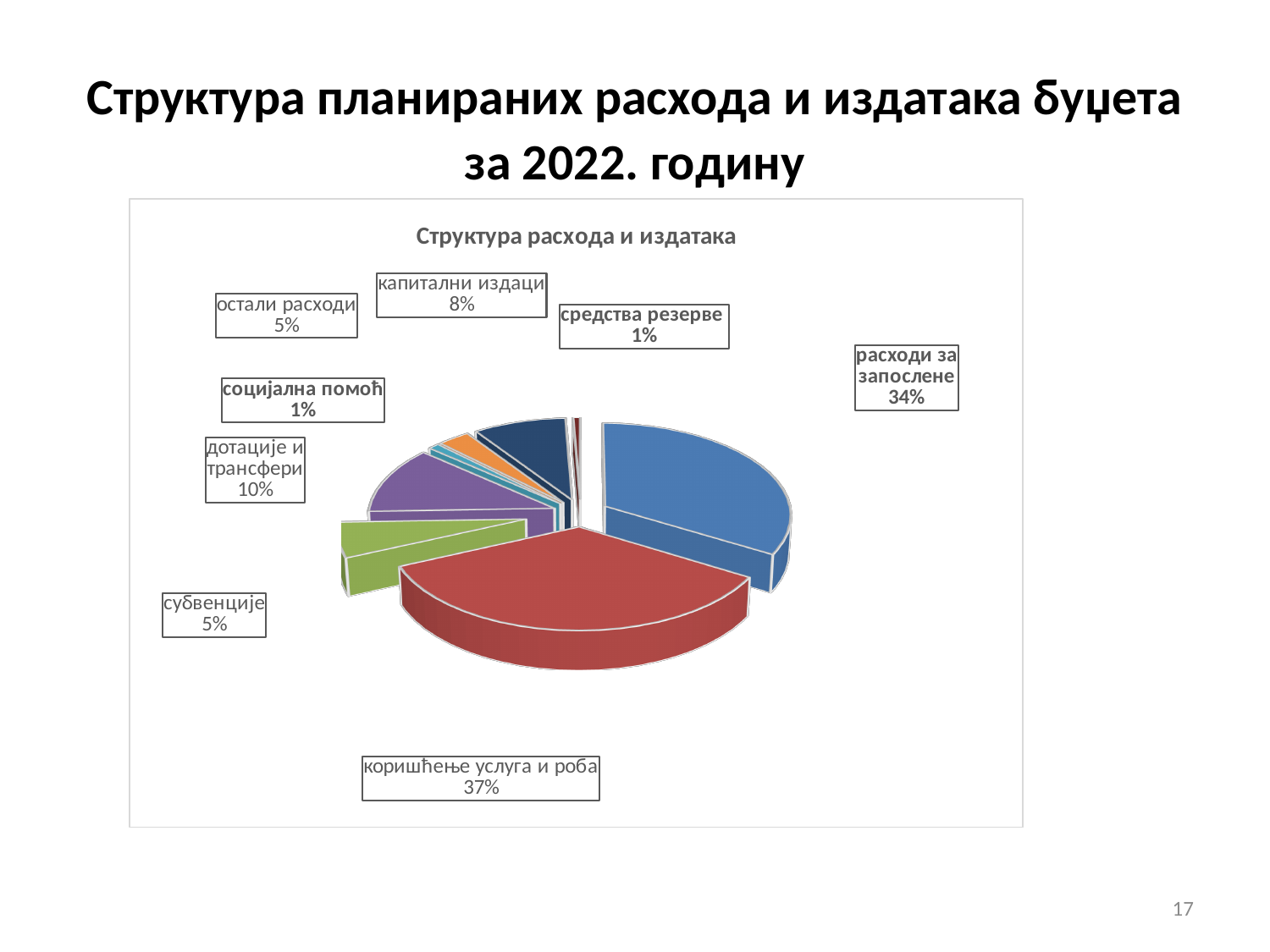
What is the difference in percentage points between коришћење услуга и роба and расходи за запослене? 3% What share of the pie is labelled for расходи за запослене? 34% What share of the pie is labelled for коришћење услуга и роба? 37% What share of the pie is labelled for дотације и трансфери? 10% Which is larger, the share for дотације и трансфери or the share for капитални издаци? дотације и трансфери How many categories are shown in the pie chart? 8 What kind of chart is shown on the slide? pie chart What is the chart's title? Структура расхода и издатака Which category has the largest share of the pie? коришћење услуга и роба